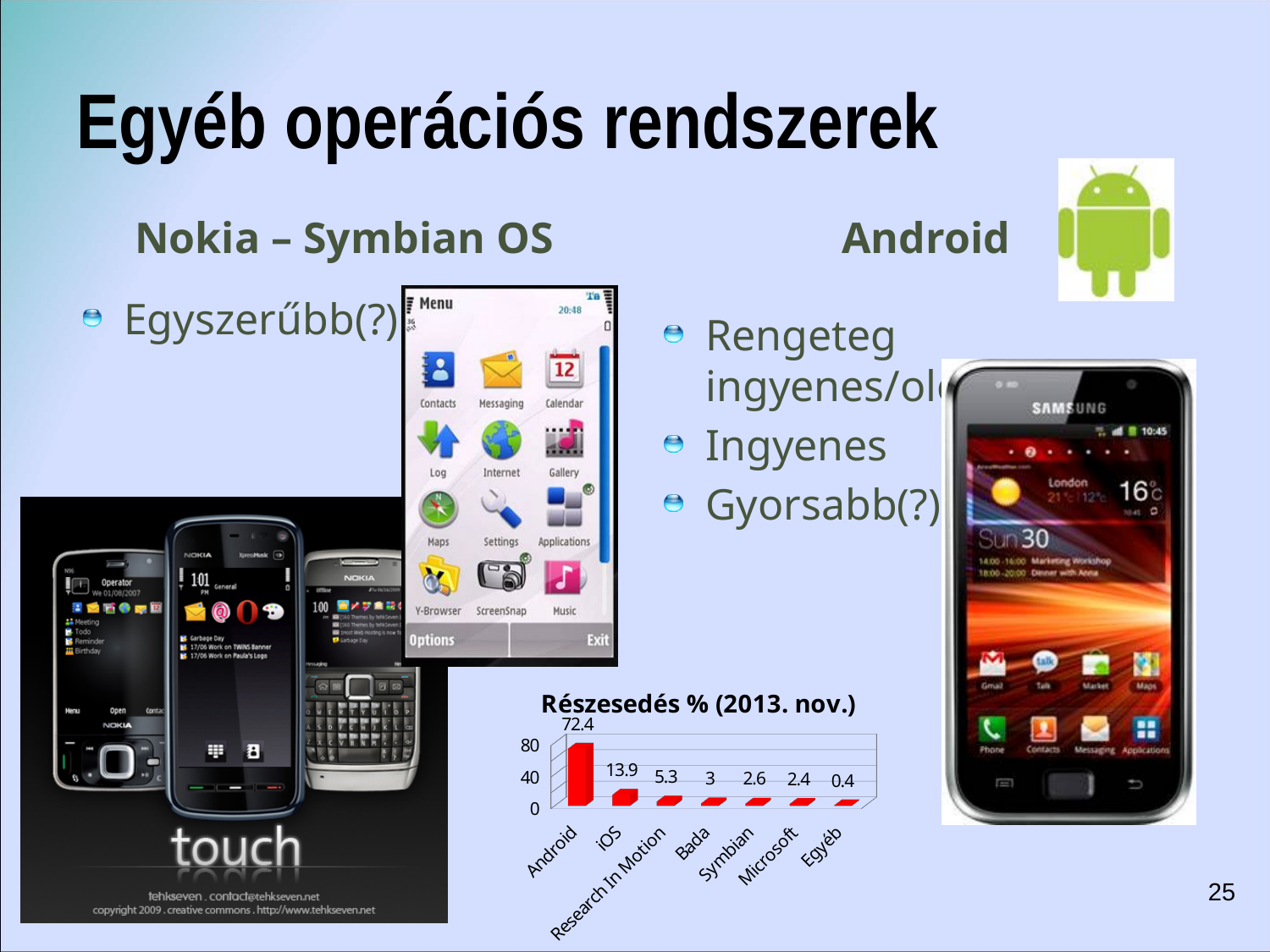
How many categories are shown in the chart? 7 What is the value for Symbian in the chart? 2.6 Which is larger, the value for Bada or the value for Microsoft? Bada What is the value for Research In Motion in the chart? 5.3 Which category has the highest value in the chart? Android What type of chart is shown on the slide? bar chart What is the value for iOS in the chart? 13.9 What is the difference between the values for Android and iOS? 58.5 Is the value for Android greater or less than 40? greater Which category has the lowest value in the chart? Egyéb What is the value for Android in the chart? 72.4 What is the title of the chart on the slide? Részesedés % (2013. nov.)